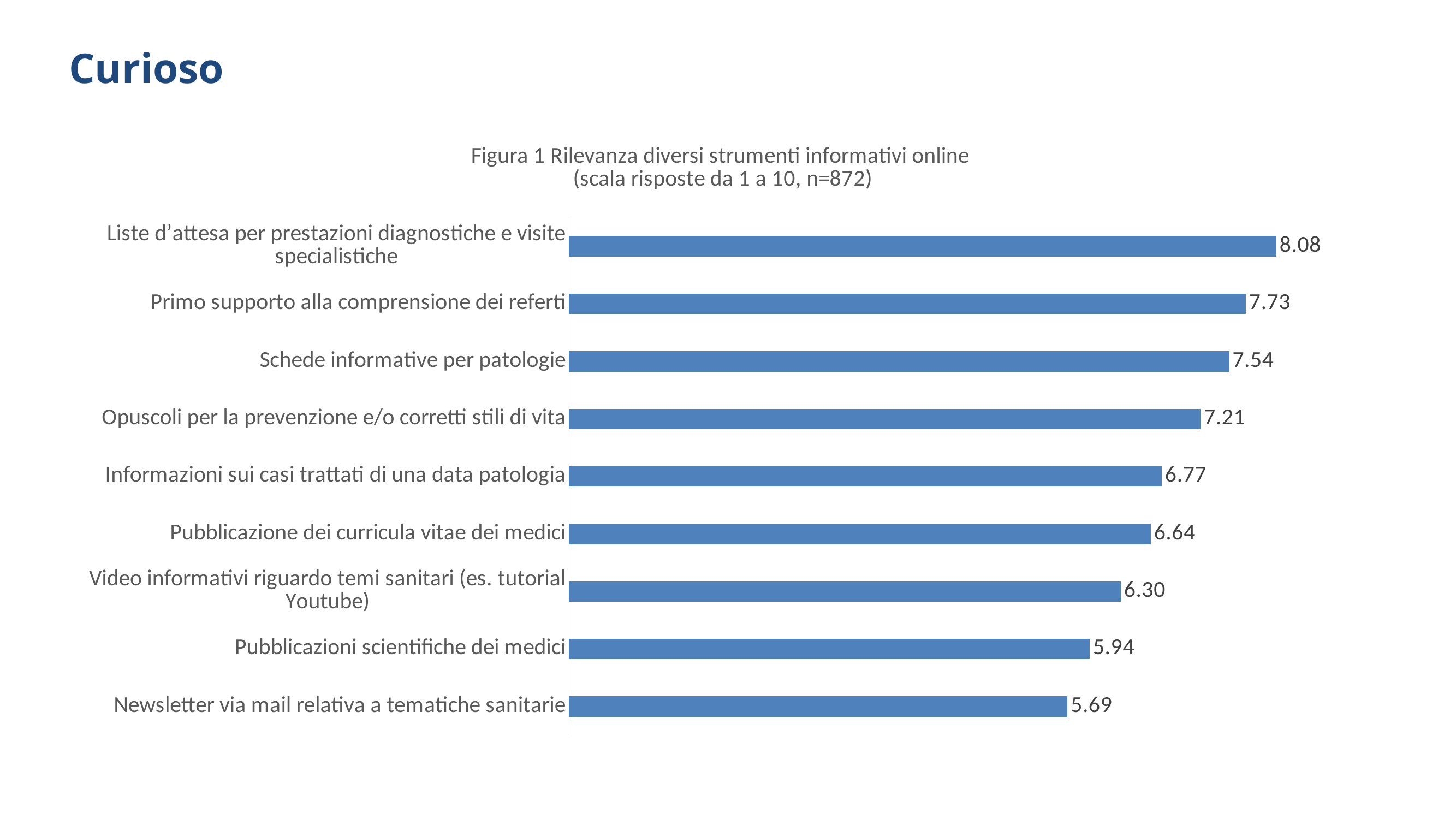
What kind of chart is shown on the slide? Bar chart What is the value for "Newsletter via mail relativa a tematiche sanitarie"? 5.69 Which category has the highest value? Liste d'attesa per prestazioni diagnostiche e visite specialistiche What is the sample size (n) stated in the chart title? 872 What is the difference between the values for "Schede informative per patologie" and "Opuscoli per la prevenzione e/o corretti stili di vita"? 0.33 What is the title of the chart? Figura 1 Rilevanza diversi strumenti informativi online (scala risposte da 1 a 10, n=872) Which category has the lowest value? Newsletter via mail relativa a tematiche sanitarie How many categories are shown in the chart? 9 What is the value for "Video informativi riguardo temi sanitari (es. tutorial Youtube)"? 6.30 What is the difference between the values for "Liste d'attesa per prestazioni diagnostiche e visite specialistiche" and "Newsletter via mail relativa a tematiche sanitarie"? 2.39 What is the value for "Primo supporto alla comprensione dei referti"? 7.73 Which is larger: the value for "Informazioni sui casi trattati di una data patologia" or for "Pubblicazioni scientifiche dei medici"? Informazioni sui casi trattati di una data patologia